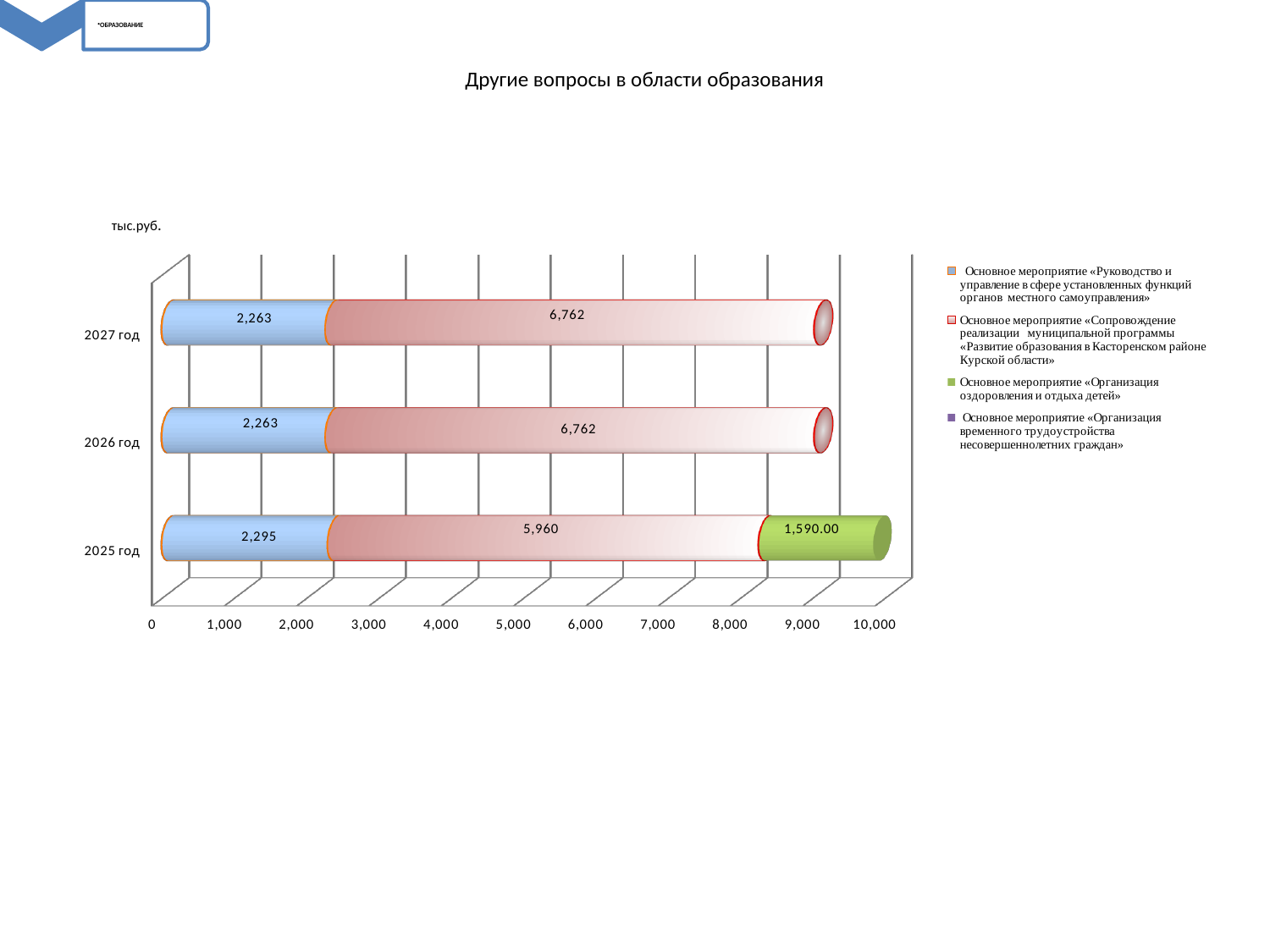
What type of chart is shown on the slide? bar chart What is the value for «Руководство и управление в сфере установленных функций органов местного самоуправления» in 2025 год? 2,295 What is the value for «Руководство и управление в сфере установленных функций органов местного самоуправления» in 2027 год? 2,263 What is the total of the stacked bar for 2027 год? 9,025 What is the value for «Организация оздоровления и отдыха детей» in 2025 год? 1,590.00 How many year categories are shown on the chart? 3 What is the difference between the «Сопровождение реализации муниципальной программы» values for 2027 год and 2025 год? 802 Which is larger: the «Руководство и управление» value for 2025 год or for 2026 год? 2025 год How many series does the legend list? 4 What unit is indicated above the chart? тыс.руб. What is the value for «Сопровождение реализации муниципальной программы «Развитие образования в Касторенском районе Курской области»» in 2026 год? 6,762 What is the total of the stacked bar for 2025 год? 9,845